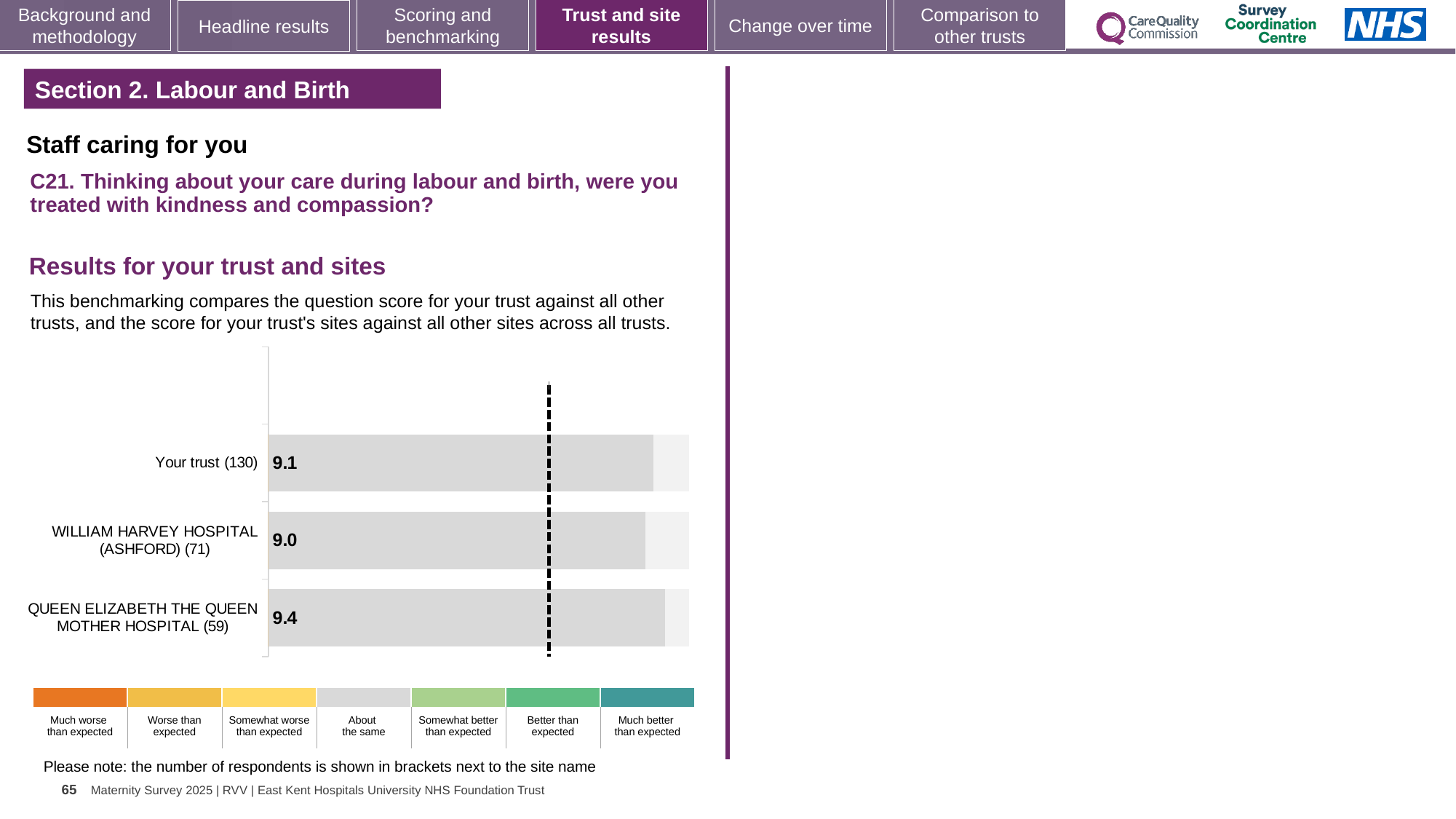
What is the score for WILLIAM HARVEY HOSPITAL (ASHFORD) (71)? 9.0 Which category has the highest score? QUEEN ELIZABETH THE QUEEN MOTHER HOSPITAL (59) What is the score for Your trust (130)? 9.1 Which category has the lowest score? WILLIAM HARVEY HOSPITAL (ASHFORD) (71) How many respondents are shown in brackets for WILLIAM HARVEY HOSPITAL (ASHFORD)? 71 How many bars are shown in the chart? 3 How many benchmark categories are shown in the colour key below the chart? 7 What is the difference between the scores for QUEEN ELIZABETH THE QUEEN MOTHER HOSPITAL (59) and Your trust (130)? 0.3 Which has a higher score, Your trust (130) or WILLIAM HARVEY HOSPITAL (ASHFORD) (71)? Your trust (130) What is the difference between the scores for QUEEN ELIZABETH THE QUEEN MOTHER HOSPITAL (59) and WILLIAM HARVEY HOSPITAL (ASHFORD) (71)? 0.4 What is the score for QUEEN ELIZABETH THE QUEEN MOTHER HOSPITAL (59)? 9.4 What kind of chart is shown on the slide? Bar chart